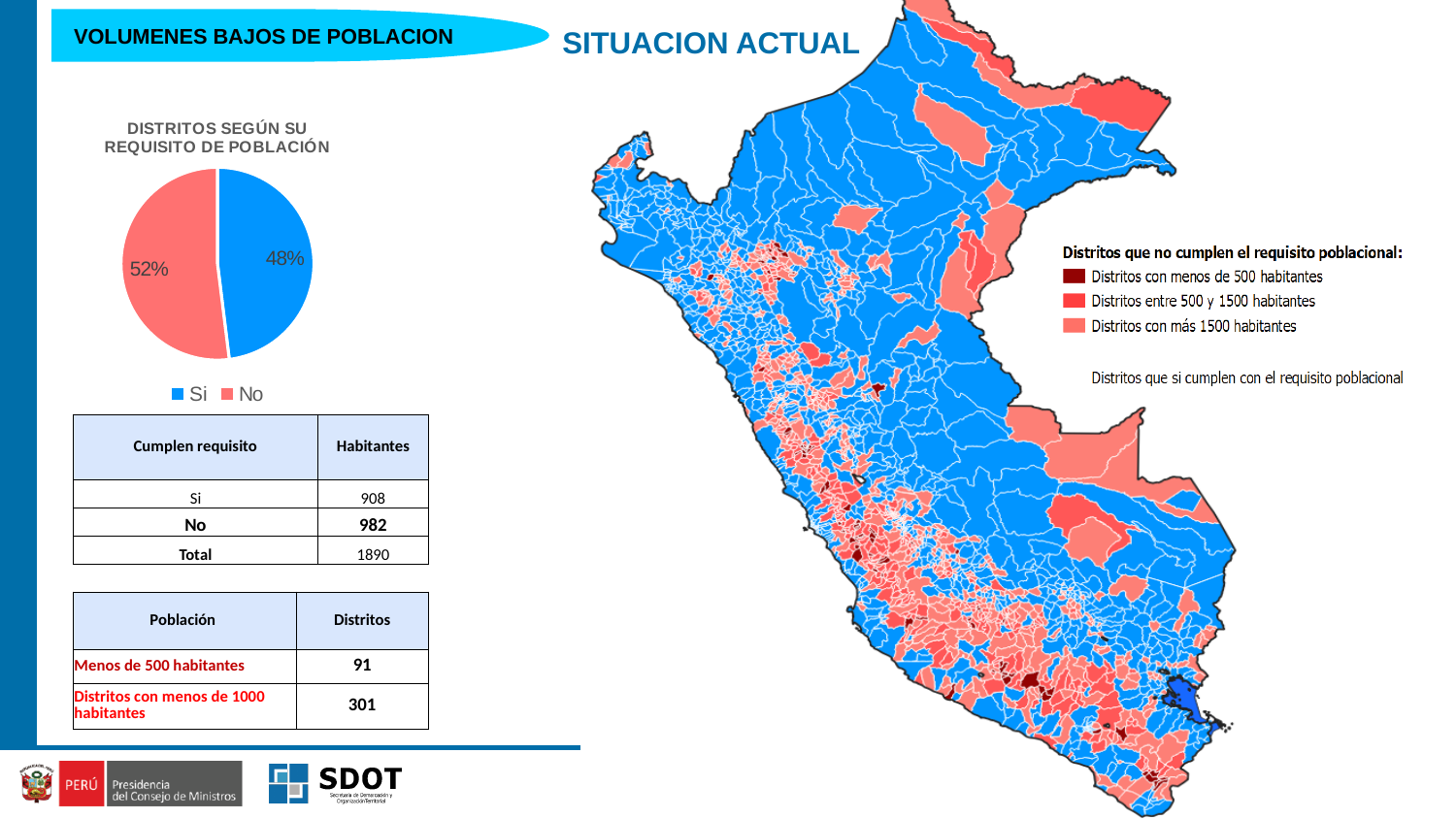
How many slices does the pie chart have? 2 What is the difference in percentage points between the 'No' and 'Si' slices of the pie chart? 4 Which slice of the pie chart is smaller, 'Si' or 'No'? Si How many entries does the pie chart's legend list? 2 In the pie chart, what percentage is shown for 'Si'? 48% What colour is the 'Si' slice in the pie chart? Blue What is the title of the pie chart? DISTRITOS SEGÚN SU REQUISITO DE POBLACIÓN In the pie chart, what percentage is shown for 'No'? 52% Which slice of the pie chart is larger, 'Si' or 'No'? No What type of chart is shown under the title 'DISTRITOS SEGÚN SU REQUISITO DE POBLACIÓN'? Pie chart Is the 'No' slice of the pie chart greater or less than 50%? greater Is the 'Si' slice of the pie chart greater or less than 50%? less